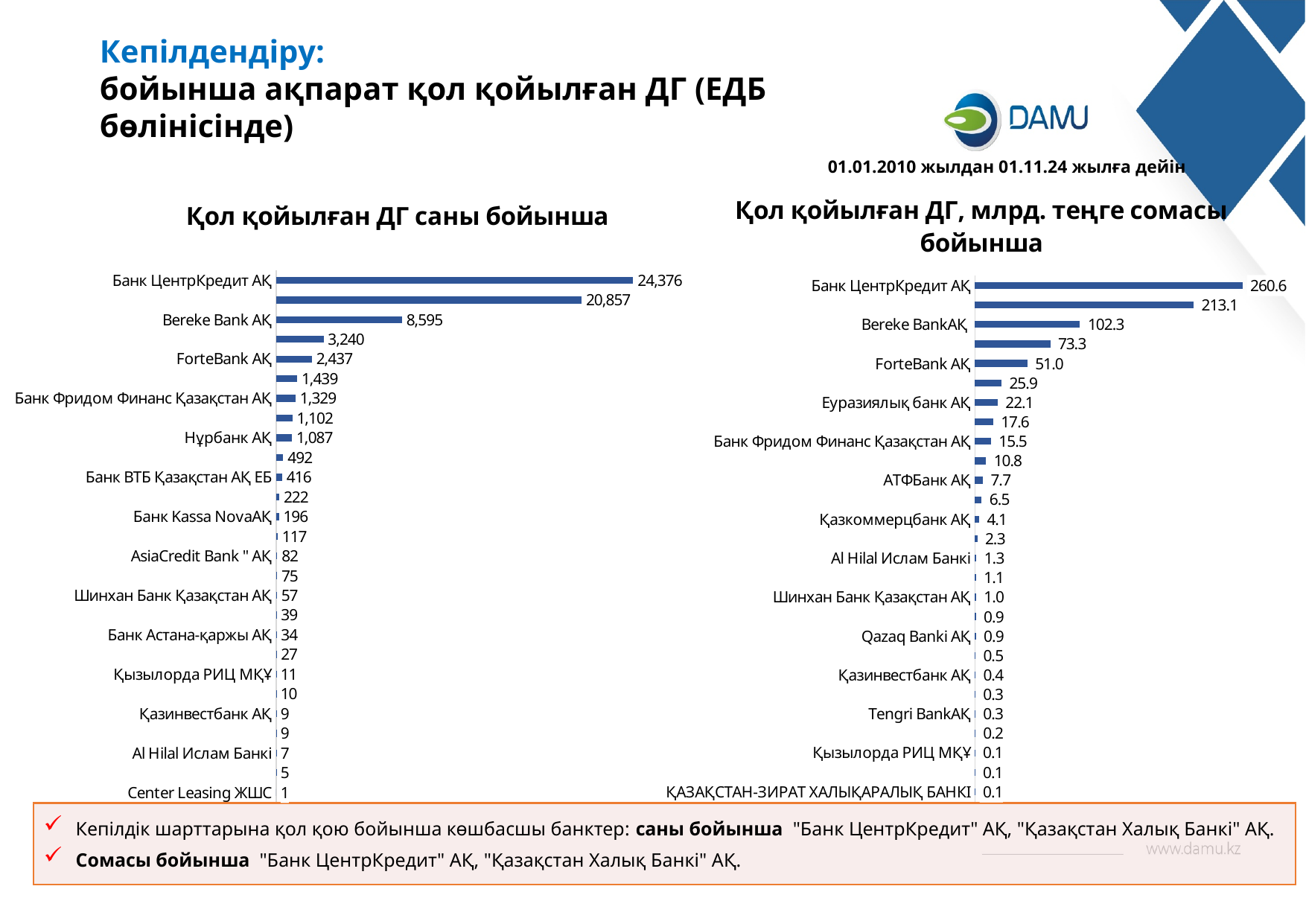
In the right chart "Қол қойылған ДГ, млрд. теңге сомасы бойынша", what is the difference between Банк ЦентрКредит АҚ and Bereke BankАҚ? 158.3 In the left chart "Қол қойылған ДГ саны бойынша", what is the value for Bereke Bank АҚ? 8,595 In the left chart "Қол қойылған ДГ саны бойынша", what is the difference between Банк ЦентрКредит АҚ and Bereke Bank АҚ? 15,781 In the left chart "Қол қойылған ДГ саны бойынша", which is larger: ForteBank АҚ or Нұрбанк АҚ? ForteBank АҚ In the left chart "Қол қойылған ДГ саны бойынша", what is the value for Нұрбанк АҚ? 1,087 In the left chart "Қол қойылған ДГ саны бойынша", which bank has the highest value? Банк ЦентрКредит АҚ In the right chart "Қол қойылған ДГ, млрд. теңге сомасы бойынша", what is the value for ForteBank АҚ? 51.0 What type of chart is the left chart titled "Қол қойылған ДГ саны бойынша"? bar chart In the right chart "Қол қойылған ДГ, млрд. теңге сомасы бойынша", what is the value for Еуразиялық банк АҚ? 22.1 What period is stated on the slide for the data shown in the charts? 01.01.2010 жылдан 01.11.24 жылға дейін In the left chart "Қол қойылған ДГ саны бойынша", what is the value for Банк ЦентрКредит АҚ? 24,376 In the right chart "Қол қойылған ДГ, млрд. теңге сомасы бойынша", what is the value for Банк ЦентрКредит АҚ? 260.6